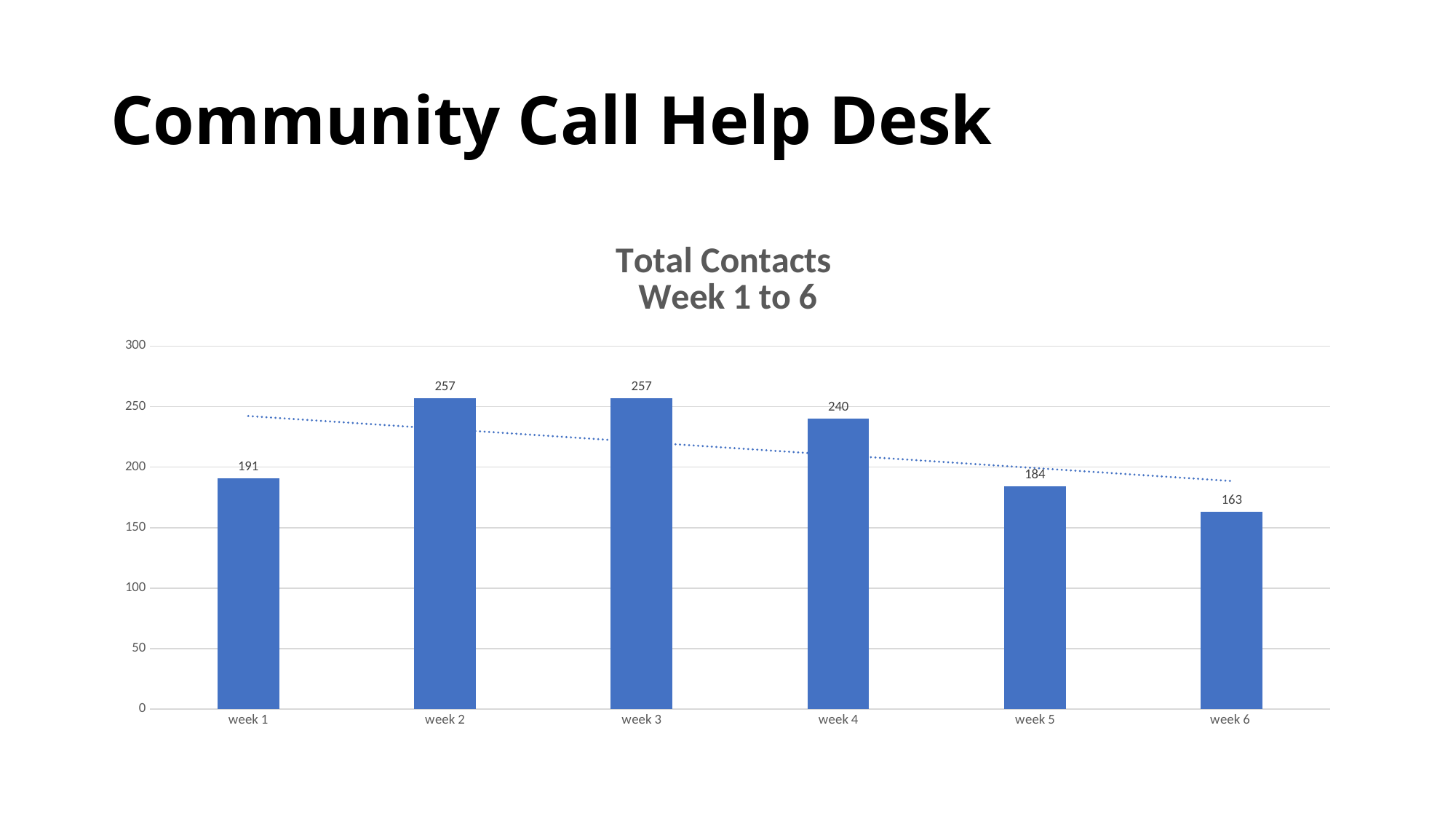
Which is larger, the value for week 1 or the value for week 5? week 1 What is the value for week 4? 240 Is the value for week 3 greater or less than 250? greater What is the value for week 6? 163 What is the title of the chart? Total Contacts Week 1 to 6 What is the difference between the values for week 4 and week 5? 56 Do the values rise or fall from week 4 to week 6? fall What is the value for week 1? 191 How many weeks are shown on the x axis? 6 What kind of chart is shown on the slide? bar chart What is the difference between the values for week 2 and week 6? 94 Which week has the lowest total contacts? week 6